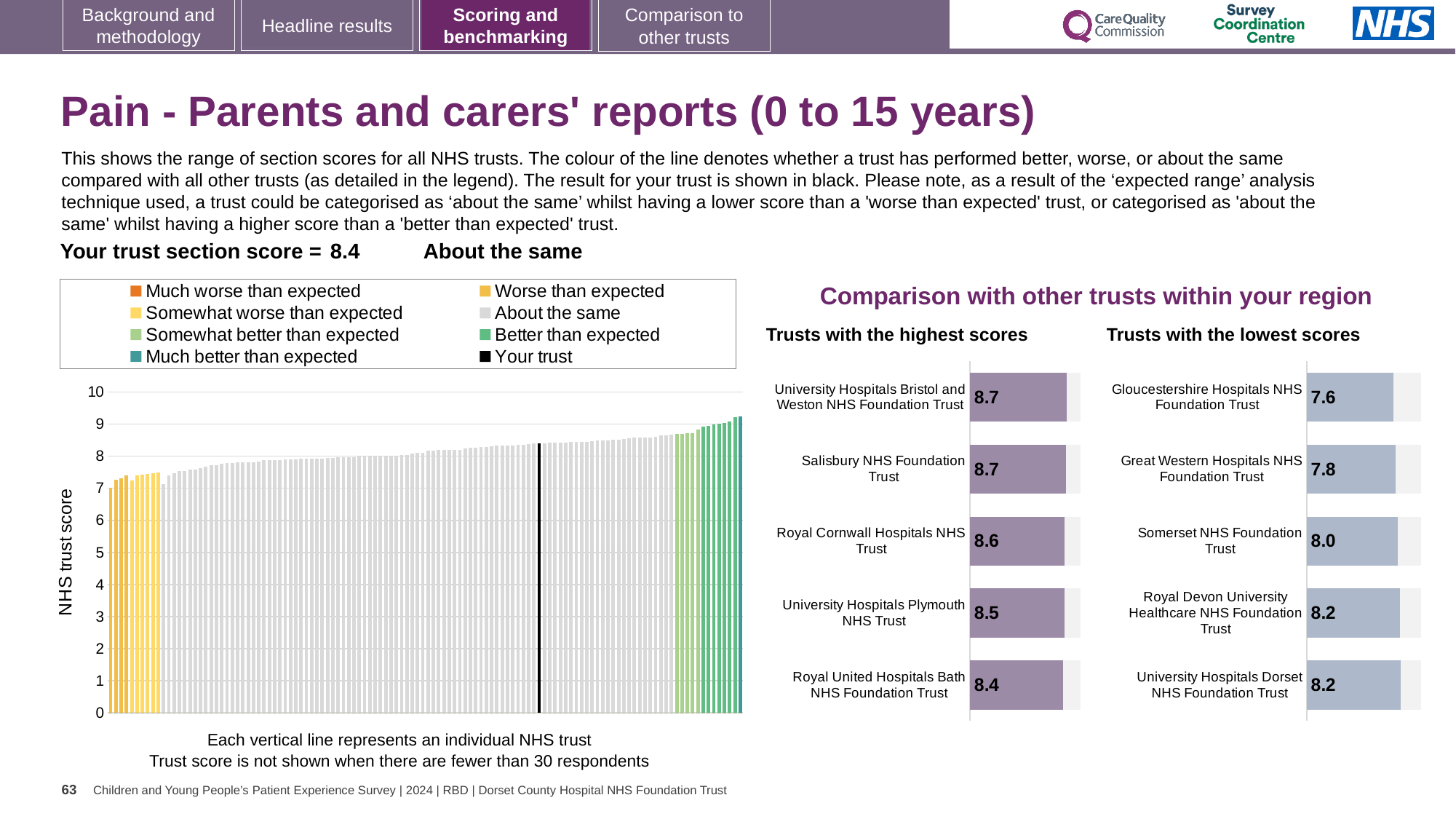
In the 'Trusts with the highest scores' chart, what is the score for Royal Cornwall Hospitals NHS Trust? 8.6 How many entries does the legend of the large chart on the left list? 8 In the 'Trusts with the lowest scores' chart, what is the difference between the score for Somerset NHS Foundation Trust and the score for Gloucestershire Hospitals NHS Foundation Trust? 0.4 In the 'Trusts with the lowest scores' chart, what is the score for Great Western Hospitals NHS Foundation Trust? 7.8 In the 'Trusts with the lowest scores' chart, which trust has the lowest score? Gloucestershire Hospitals NHS Foundation Trust What kind of chart is the large chart on the left showing all NHS trusts? bar chart In the 'Trusts with the lowest scores' chart, which has the larger score: Great Western Hospitals NHS Foundation Trust or Somerset NHS Foundation Trust? Somerset NHS Foundation Trust In the 'Trusts with the highest scores' chart, what is the score for University Hospitals Plymouth NHS Trust? 8.5 In the large chart on the left showing all NHS trusts, is the value for the black bar (your trust) greater or less than 8? greater In the large chart on the left showing all NHS trusts, are the values for the yellow bars at the far left greater or less than 6? greater How many trusts are listed in the 'Trusts with the highest scores' chart? 5 In the 'Trusts with the highest scores' chart, what is the difference between the score for University Hospitals Bristol and Weston NHS Foundation Trust and the score for Royal United Hospitals Bath NHS Foundation Trust? 0.3